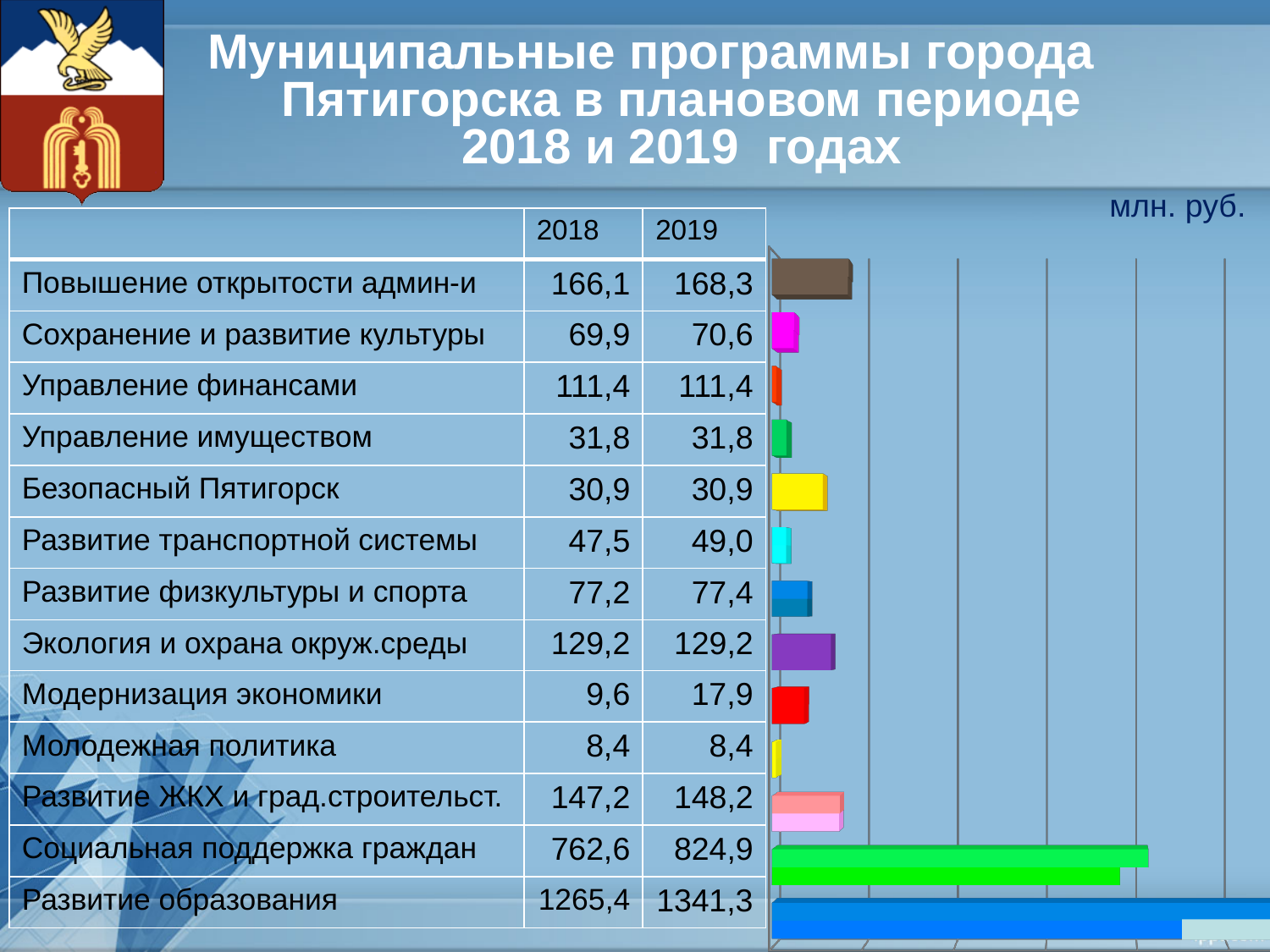
Which is larger in 2018: Повышение открытости админ-и or Экология и охрана окруж.среды? Повышение открытости админ-и In what units are the values on the slide given? млн. руб. What is the value for Социальная поддержка граждан in 2018? 762,6 How many municipal programmes (categories) are listed on the slide? 13 What is the value for Модернизация экономики in 2019? 17,9 What is the difference between the 2019 and 2018 values for Социальная поддержка граждан? 62,3 What is the difference between the 2019 and 2018 values for Развитие образования? 75,9 Which programme has the lowest value in 2018? Молодежная политика What is the value for Развитие образования in 2019? 1341,3 Which programme has the highest value in 2019? Развитие образования What is the value for Безопасный Пятигорск in 2018? 30,9 What kind of chart is shown on the slide? bar chart